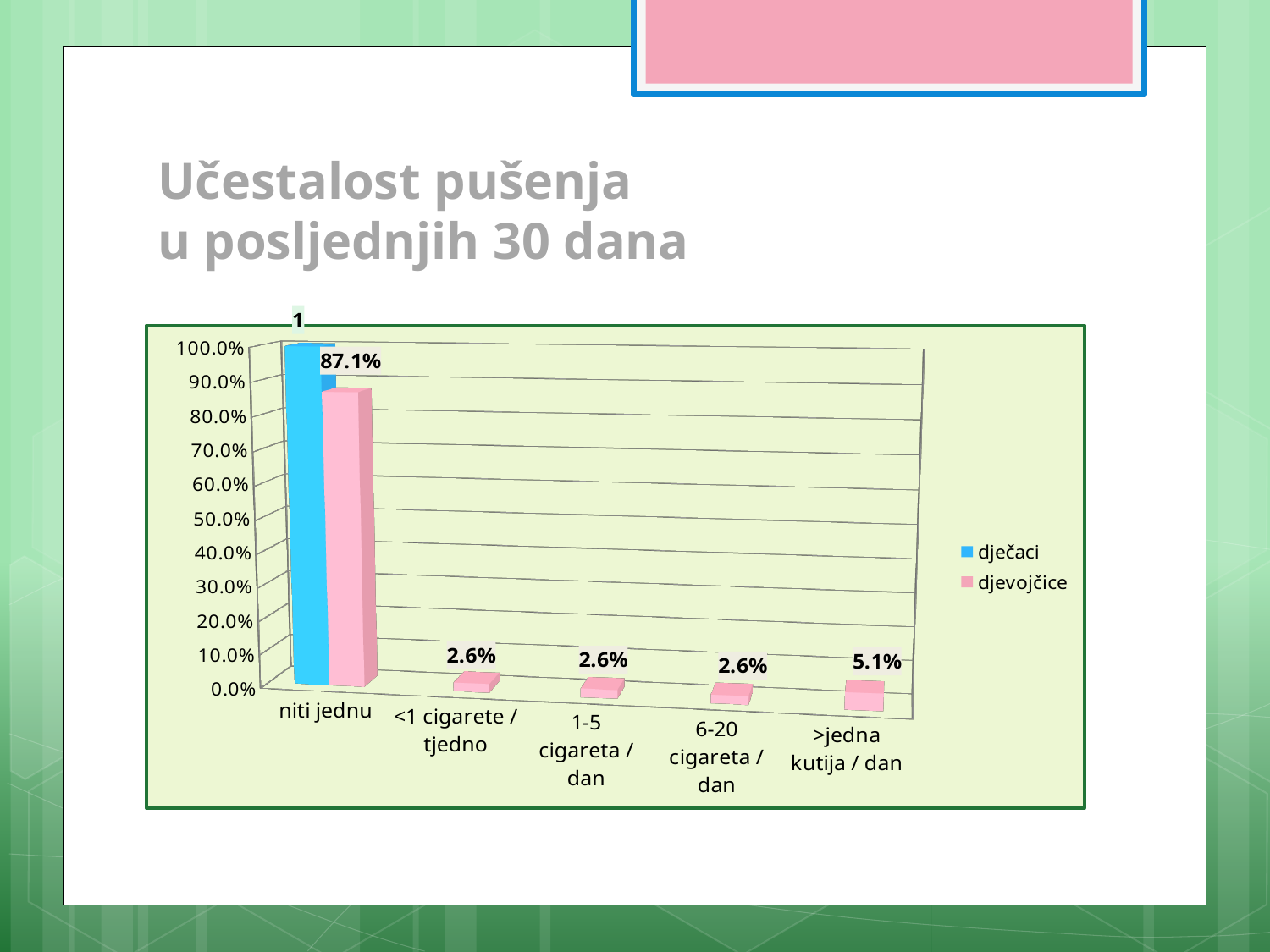
What data label is printed above the dječaci bar in the 'niti jednu' category? 1 How many categories are shown on the x axis? 5 What is the value for djevojčice in the 'niti jednu' category? 87.1% What is the value for djevojčice in the '>jedna kutija / dan' category? 5.1% Which is larger for djevojčice: '6-20 cigareta / dan' or '>jedna kutija / dan'? >jedna kutija / dan What is the value for djevojčice in the '<1 cigarete / tjedno' category? 2.6% What is the difference between the djevojčice values for 'niti jednu' and '>jedna kutija / dan'? 82.0% How many series does the legend list? 2 What kind of chart is shown on the slide? bar chart What are the two entries in the chart legend? dječaci, djevojčice Is the value for dječaci in the 'niti jednu' category greater or less than 90.0%? greater Which category has the highest value for djevojčice? niti jednu